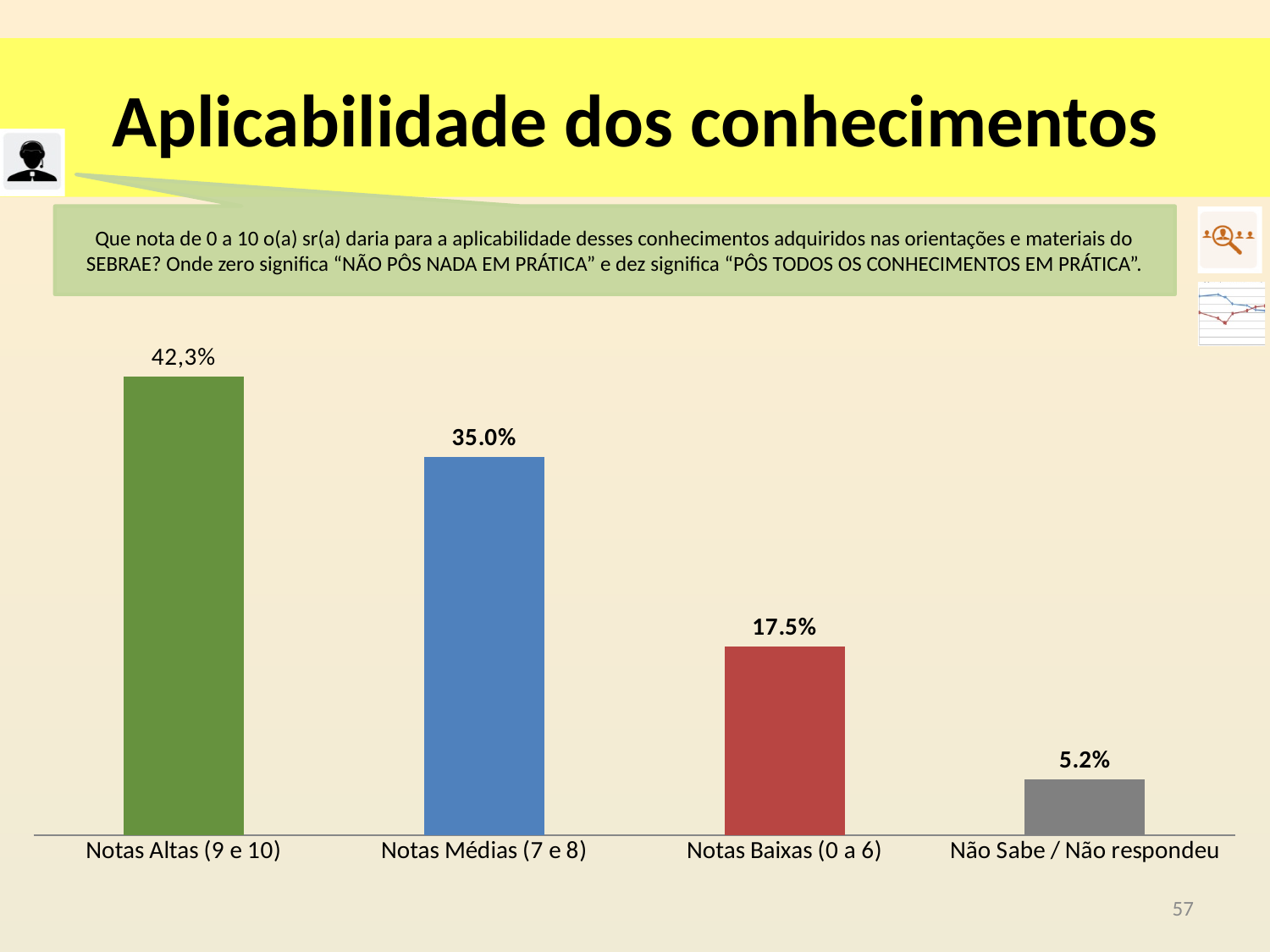
What is the difference between Notas Médias (7 e 8) and Notas Baixas (0 a 6)? 17.5% What is the value for Notas Médias (7 e 8)? 35.0% What is the value for Notas Altas (9 e 10)? 42,3% Which category has the lowest value? Não Sabe / Não respondeu Do the values rise or fall from left to right across the categories? fall What is the difference between Notas Baixas (0 a 6) and Não Sabe / Não respondeu? 12.3% What is the value for Não Sabe / Não respondeu? 5.2% How many categories are shown in the chart? 4 Which is larger, Notas Médias (7 e 8) or Notas Baixas (0 a 6)? Notas Médias (7 e 8) What is the value for Notas Baixas (0 a 6)? 17.5% What kind of chart is shown on the slide? bar chart Which category has the highest value? Notas Altas (9 e 10)